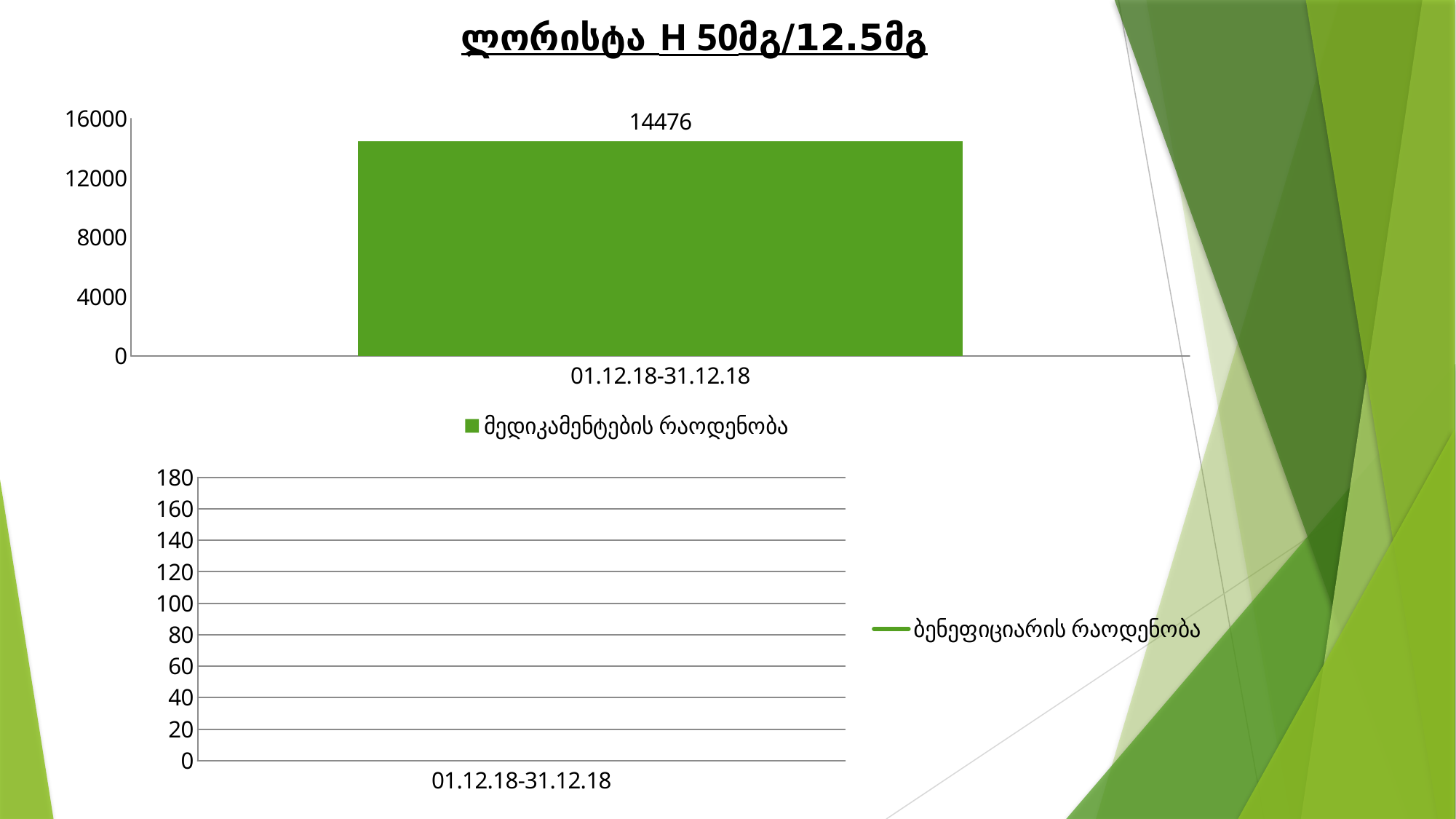
How many categories are shown on the x axis of the bottom chart? 1 In the top chart, is the value for 01.12.18-31.12.18 greater or less than 16000? less What category label appears on the x axis of the bottom chart? 01.12.18-31.12.18 How many series does the legend of the bottom chart list? 1 In the top chart, is the value for 01.12.18-31.12.18 greater or less than 12000? greater What is the legend entry of the bottom chart? ბენეფიციარის რაოდენობა What kind of chart is the top chart? bar chart How many series does the legend of the top chart list? 1 How many bars does the top chart show? 1 In the top chart, what is the value for 01.12.18-31.12.18? 14476 What is the title of the slide above the charts? ლორისტა H 50მგ/12.5მგ What is the legend entry of the top chart? მედიკამენტების რაოდენობა